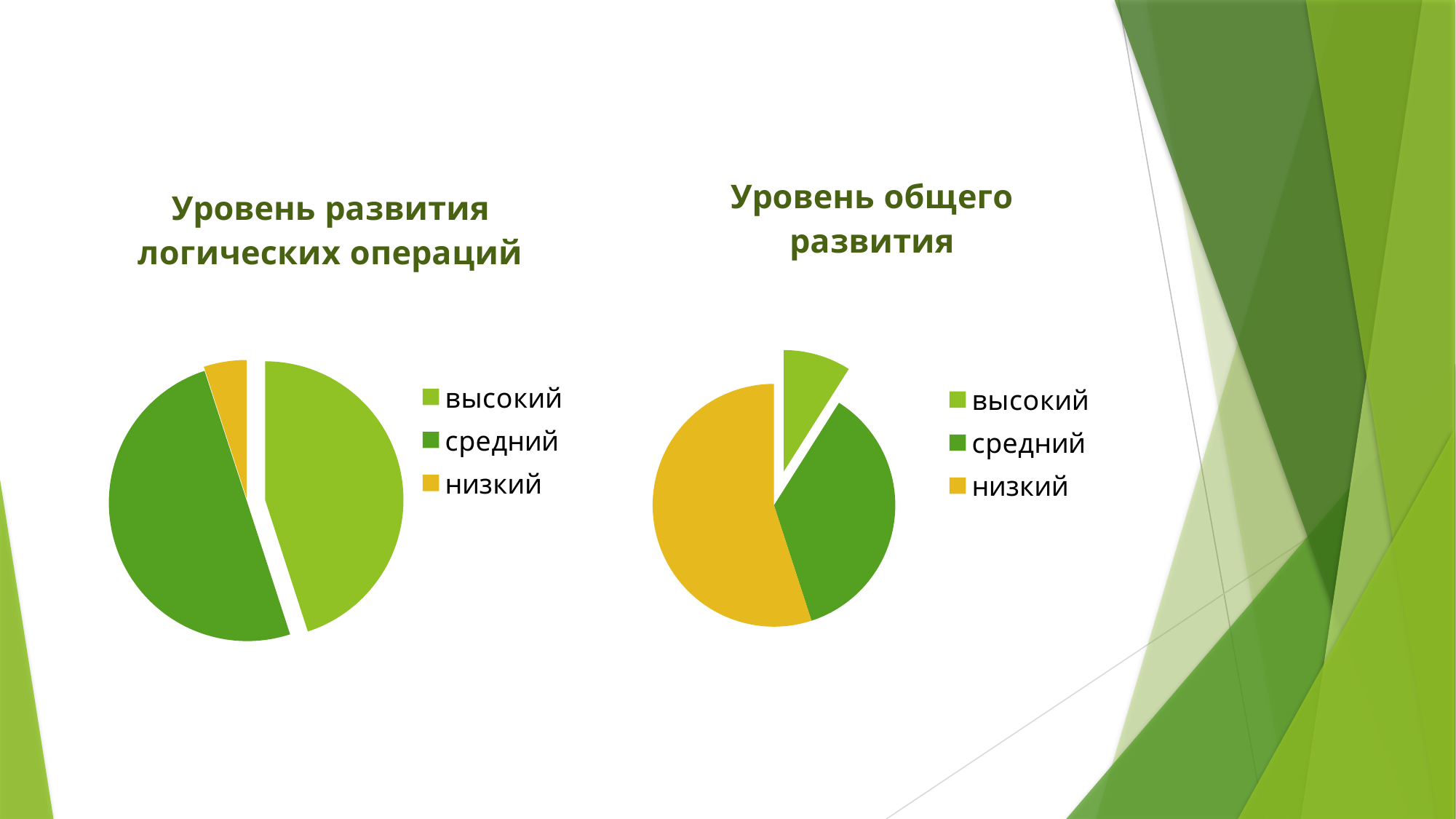
In the chart titled "Уровень развития логических операций", which slice is larger: высокий or низкий? высокий In the chart titled "Уровень развития логических операций", which category has the smallest slice? низкий In the chart titled "Уровень общего развития", which slice is larger: средний or высокий? средний In the chart titled "Уровень общего развития", which category has the smallest slice? высокий What kind of chart is the chart titled "Уровень развития логических операций"? pie chart In the chart titled "Уровень общего развития", how many entries does the legend list? 3 In the chart titled "Уровень общего развития", which category has the largest slice? низкий What is the title of the pie chart on the left of the slide? Уровень развития логических операций What kind of chart is the chart titled "Уровень общего развития"? pie chart In the chart titled "Уровень развития логических операций", how many slices does the pie have? 3 In the chart titled "Уровень общего развития", what colour is the slice for низкий? yellow In the chart titled "Уровень общего развития", which slice is larger: низкий or средний? низкий